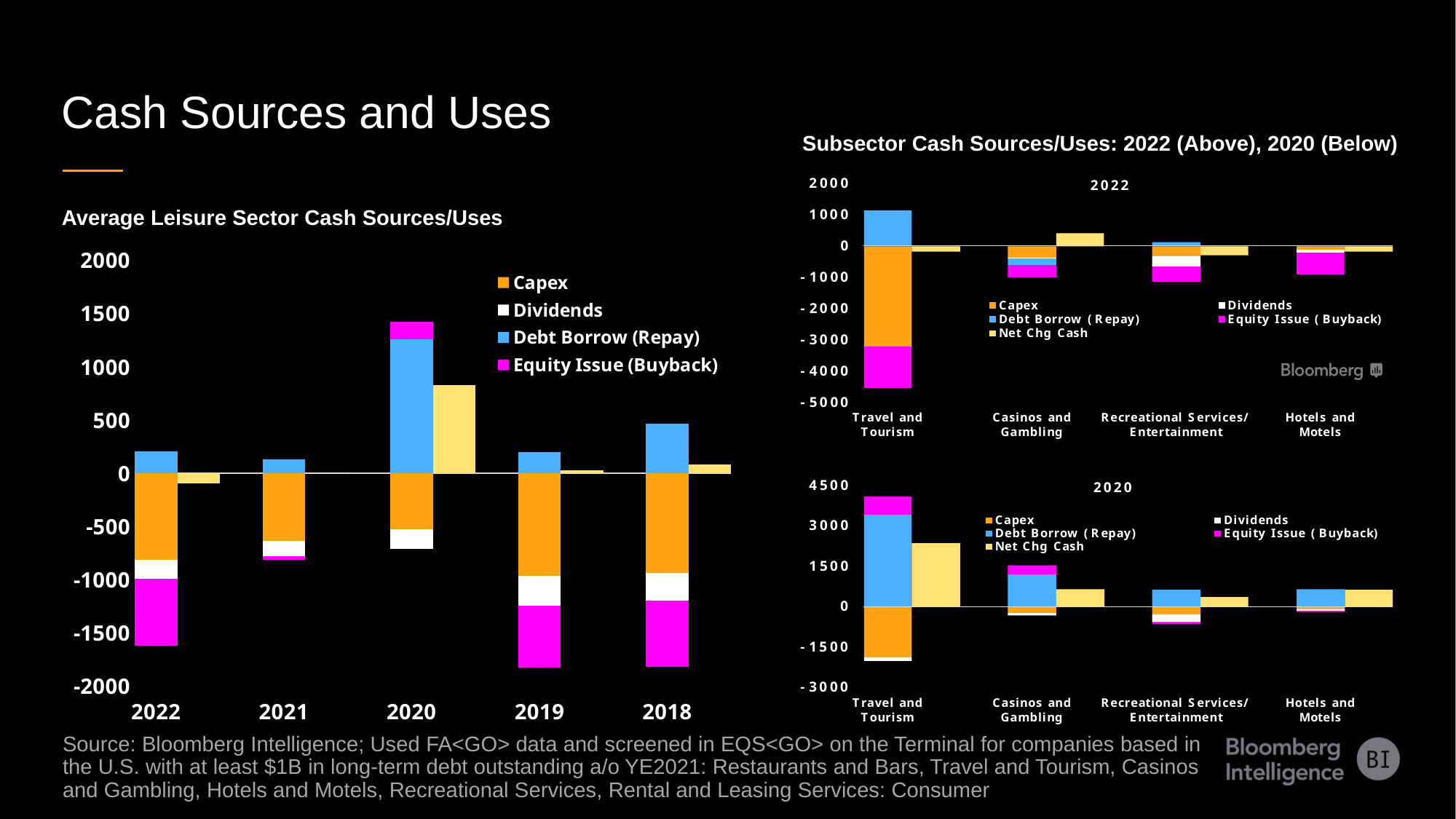
In the 'Average Leisure Sector Cash Sources/Uses' chart, is the Debt Borrow (Repay) value for 2020 greater or less than 1000? greater In the 'Average Leisure Sector Cash Sources/Uses' chart, is the Debt Borrow (Repay) value larger in 2020 or in 2018? 2020 In the 'Average Leisure Sector Cash Sources/Uses' chart, is the Equity Issue (Buyback) value for 2019 greater or less than -1500? greater How many series does the legend of the 'Average Leisure Sector Cash Sources/Uses' chart list? 4 What kind of chart is the 'Average Leisure Sector Cash Sources/Uses' chart? Stacked bar chart In the 'Average Leisure Sector Cash Sources/Uses' chart, which year has the highest net change in cash (yellow bar)? 2020 How many subsectors are shown on the x axis of the 2022 subsector chart? 4 In the 2022 subsector chart, is the Equity Issue (Buyback) value for Travel and Tourism greater or less than -4000? greater How many series does the legend of the 2020 subsector chart list? 5 How many years are shown on the x axis of the 'Average Leisure Sector Cash Sources/Uses' chart? 5 In the 2020 subsector chart, which subsector has the largest Net Chg Cash value? Travel and Tourism